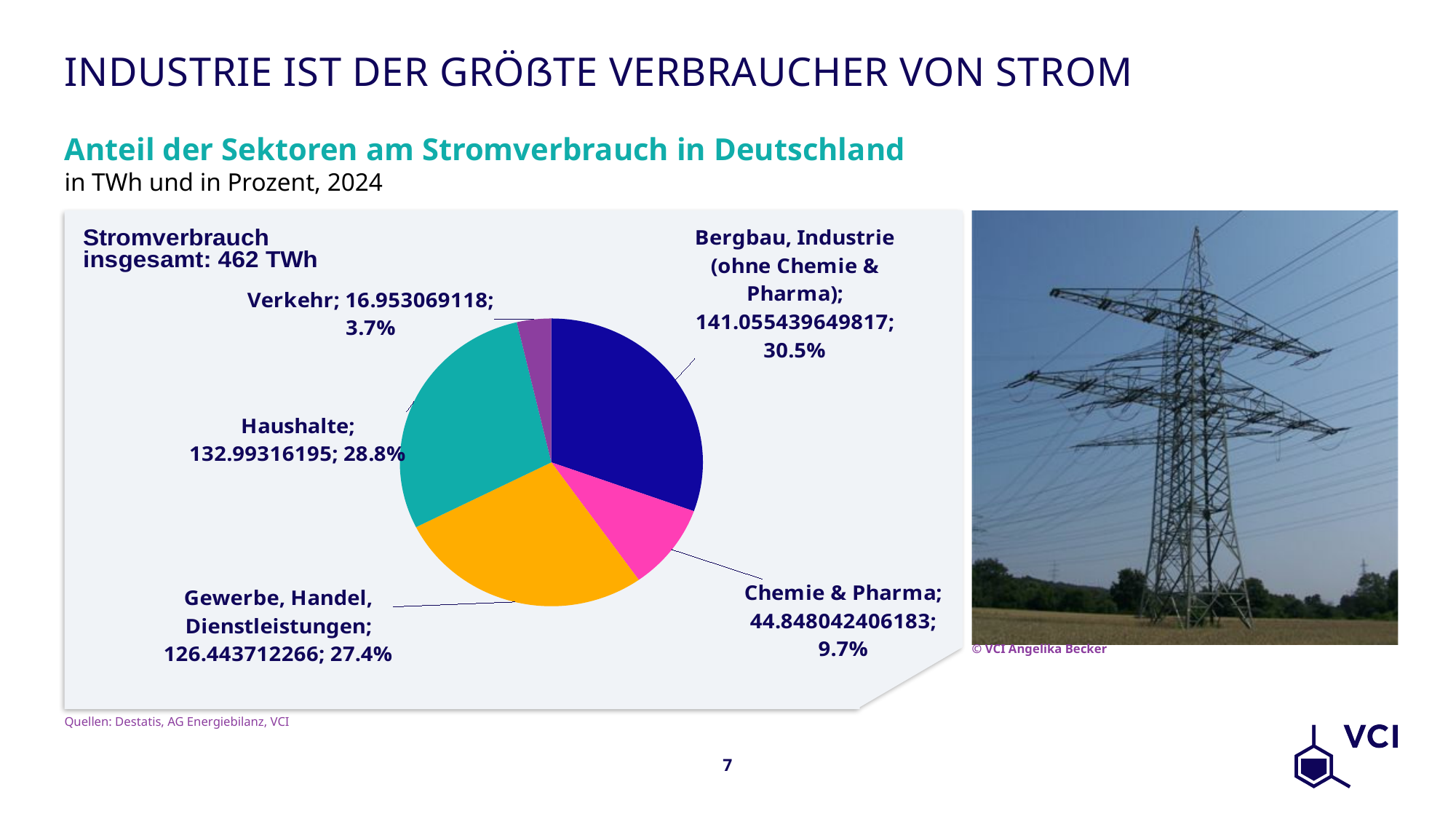
What share of the pie does Verkehr account for? 3.7% Which sector has the largest share of electricity consumption? Bergbau, Industrie (ohne Chemie & Pharma) What percentage is shown for Bergbau, Industrie (ohne Chemie & Pharma)? 30.5% Which sector has the smallest share of electricity consumption? Verkehr What share of electricity consumption does the Haushalte slice represent? 28.8% How many sectors (slices) does the pie chart show? 5 What value in TWh is shown for Gewerbe, Handel, Dienstleistungen? 126.443712266 What kind of chart is shown on the slide? pie chart What total electricity consumption (Stromverbrauch insgesamt) is stated on the chart? 462 TWh What is the difference in percentage points between the shares of Bergbau, Industrie (ohne Chemie & Pharma) and Chemie & Pharma? 20.8 percentage points What is the value in TWh shown for Chemie & Pharma? 44.848042406183 Which has the larger share: Haushalte or Gewerbe, Handel, Dienstleistungen? Haushalte